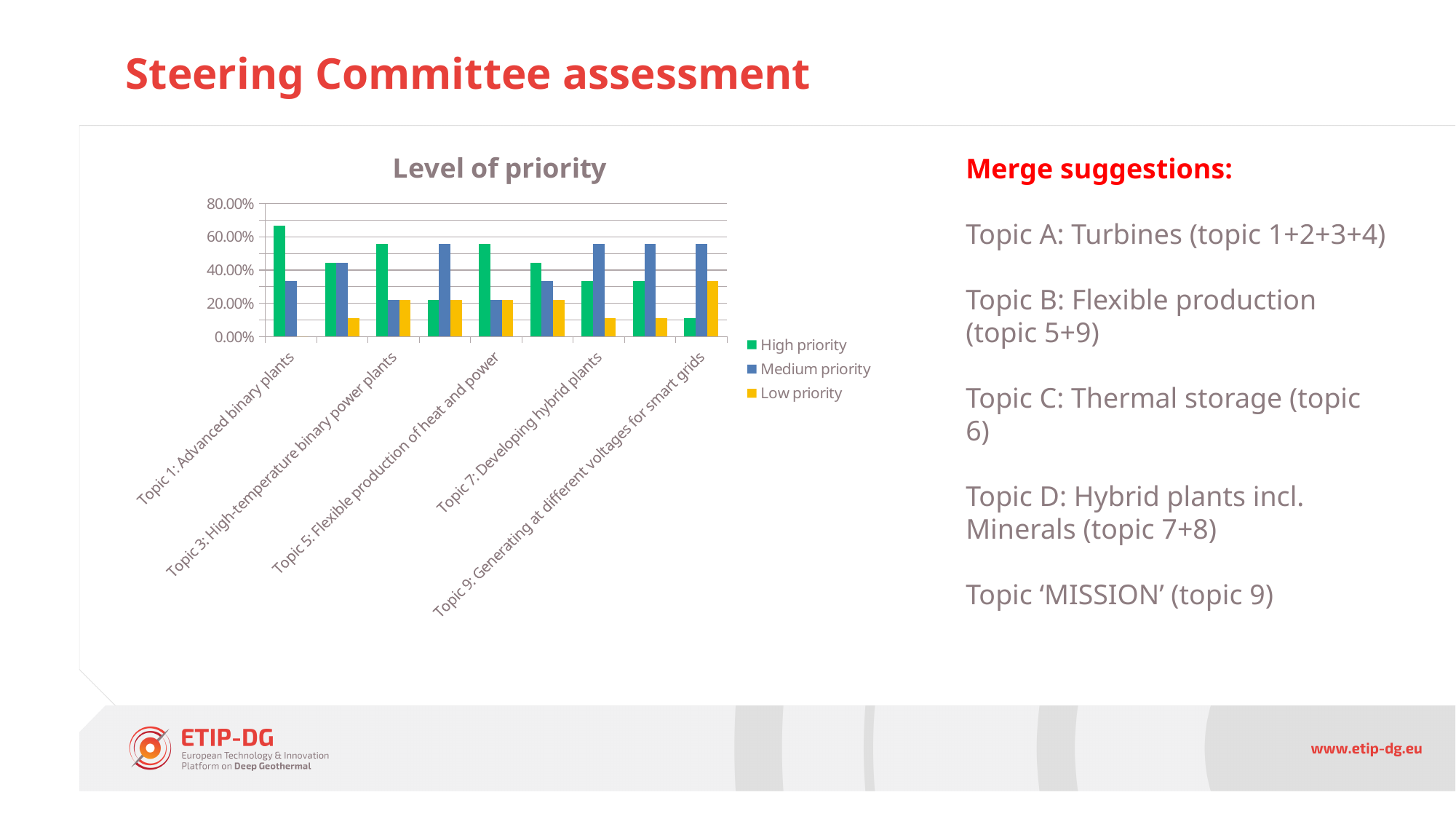
For Topic 5: Flexible production of heat and power, which is larger, the High priority or the Medium priority value? High priority Which topic has the highest High priority bar? Topic 1: Advanced binary plants What kind of chart is shown on the slide? Bar chart Is the High priority value for Topic 1: Advanced binary plants greater or less than 60.00%? greater How many groups of bars are plotted in the chart? 9 Among the labelled topics, which has the lowest High priority bar? Topic 9: Generating at different voltages for smart grids Is the Medium priority value for Topic 1: Advanced binary plants greater or less than 40.00%? less What is the title of the chart? Level of priority Is the Low priority value for Topic 9: Generating at different voltages for smart grids greater or less than 20.00%? greater For Topic 7: Developing hybrid plants, which is larger, the High priority or the Medium priority value? Medium priority How many series does the chart legend list? 3 What colour represents the Low priority series in the chart? Yellow